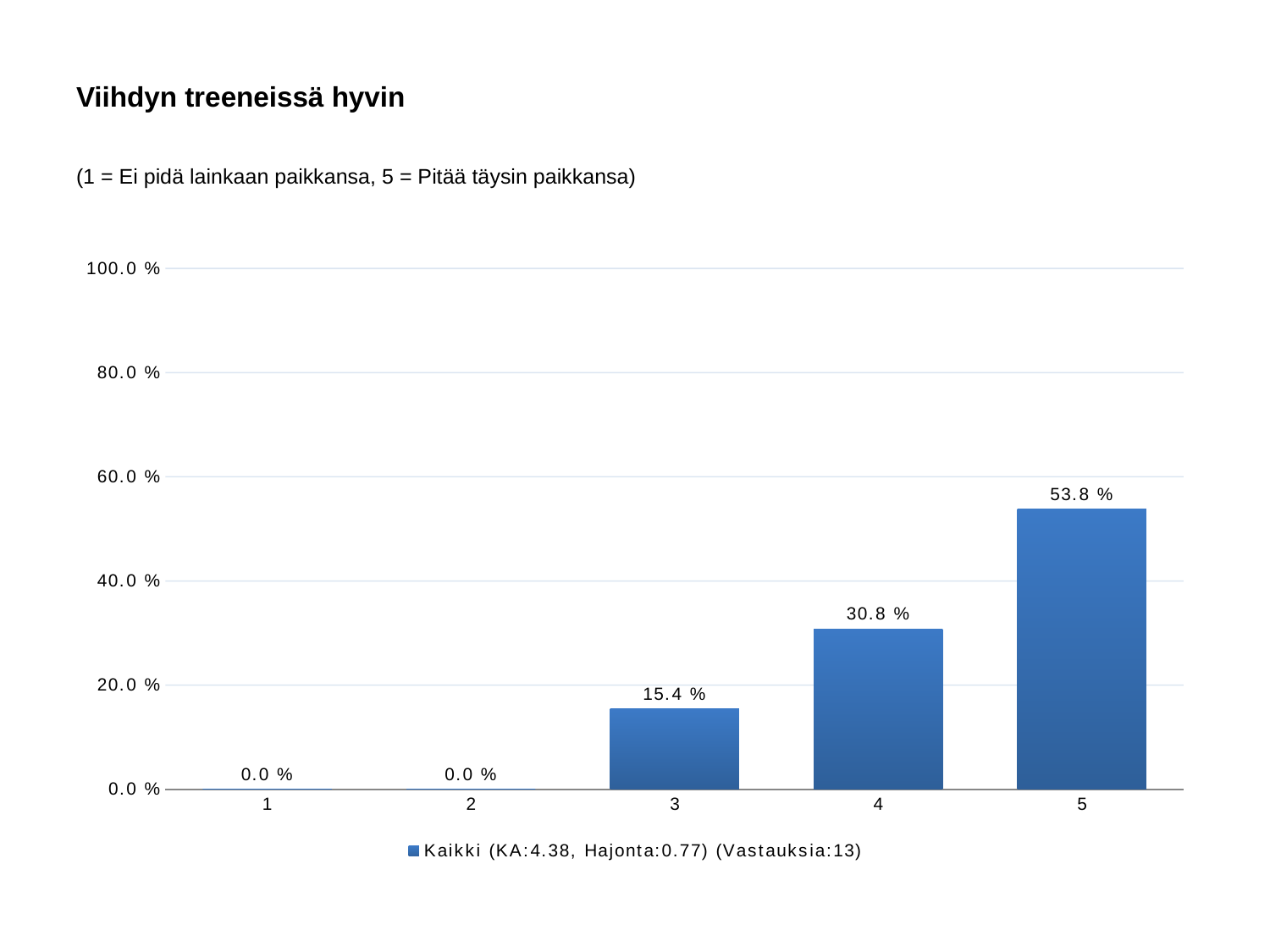
What is the value shown for rating 1? 0.0 % What kind of chart is shown on the slide? bar chart Which rating has the highest percentage? 5 How many rating categories are shown on the x axis? 5 What is the value shown for rating 4? 30.8 % What is the value shown for rating 3? 15.4 % What is the difference between the values for rating 5 and rating 4? 23.0 % Is the value for rating 5 greater or less than 40.0 %? greater Which is larger, the value for rating 3 or the value for rating 4? 4 What percentage of respondents chose rating 5? 53.8 % What is the title of the slide? Viihdyn treeneissä hyvin How many series does the legend list? 1